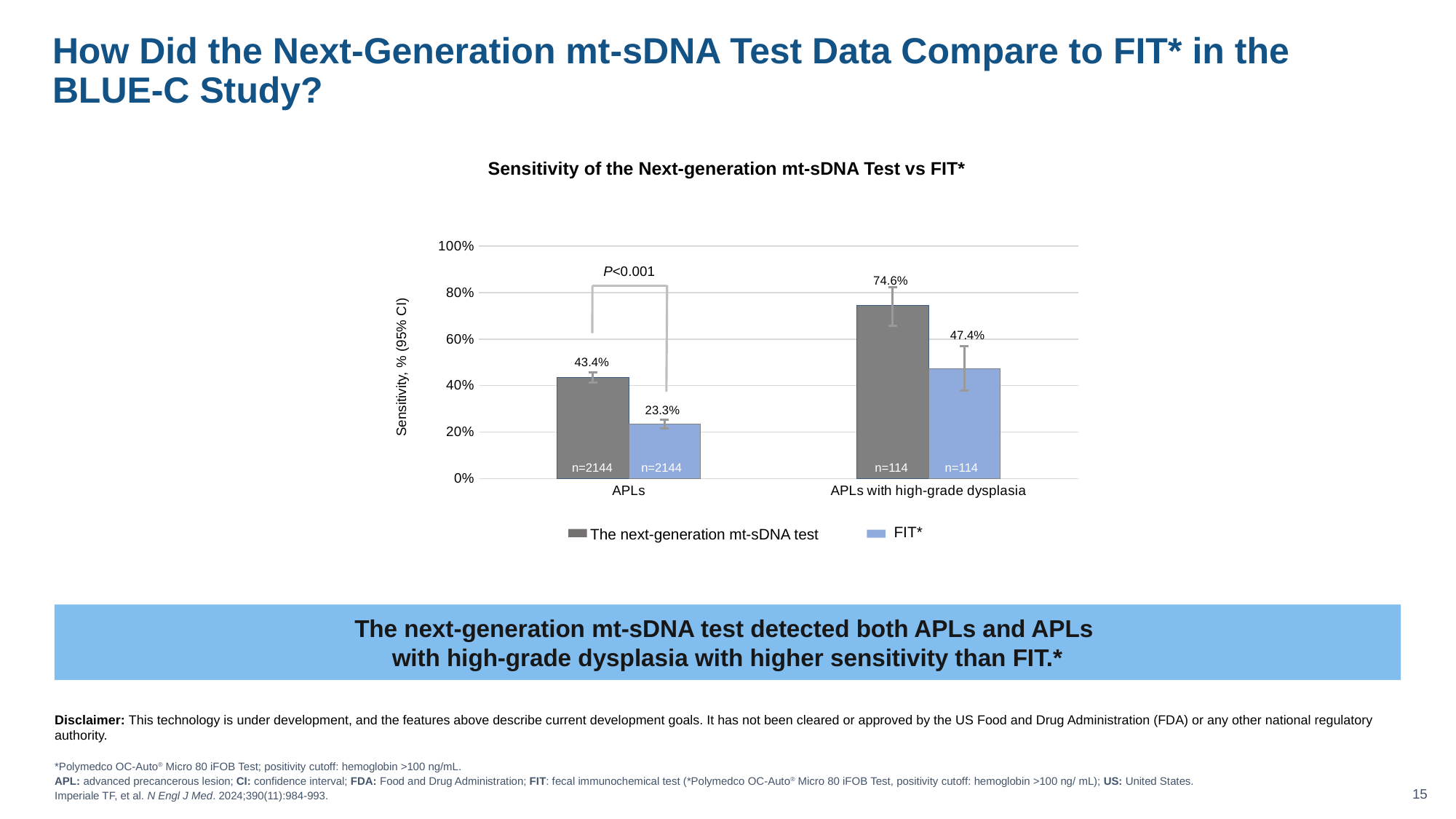
How many series does the chart legend list? 2 What is the sensitivity of FIT* for APLs with high-grade dysplasia? 47.4% What is the sensitivity of the next-generation mt-sDNA test for APLs? 43.4% What is the sample size (n) shown for the APLs category? n=2144 Which bar has the lowest sensitivity value on the chart? FIT* for APLs (23.3%) What type of chart is shown on the slide? Bar chart What is the sensitivity of FIT* for APLs? 23.3% What is the difference in sensitivity between the next-generation mt-sDNA test and FIT* for APLs with high-grade dysplasia? 27.2% How many categories are shown on the x axis of the chart? 2 Which bar has the highest sensitivity value on the chart? The next-generation mt-sDNA test for APLs with high-grade dysplasia (74.6%) What is the difference in sensitivity between the next-generation mt-sDNA test and FIT* for APLs? 20.1% For APLs with high-grade dysplasia, which test has the higher sensitivity? The next-generation mt-sDNA test